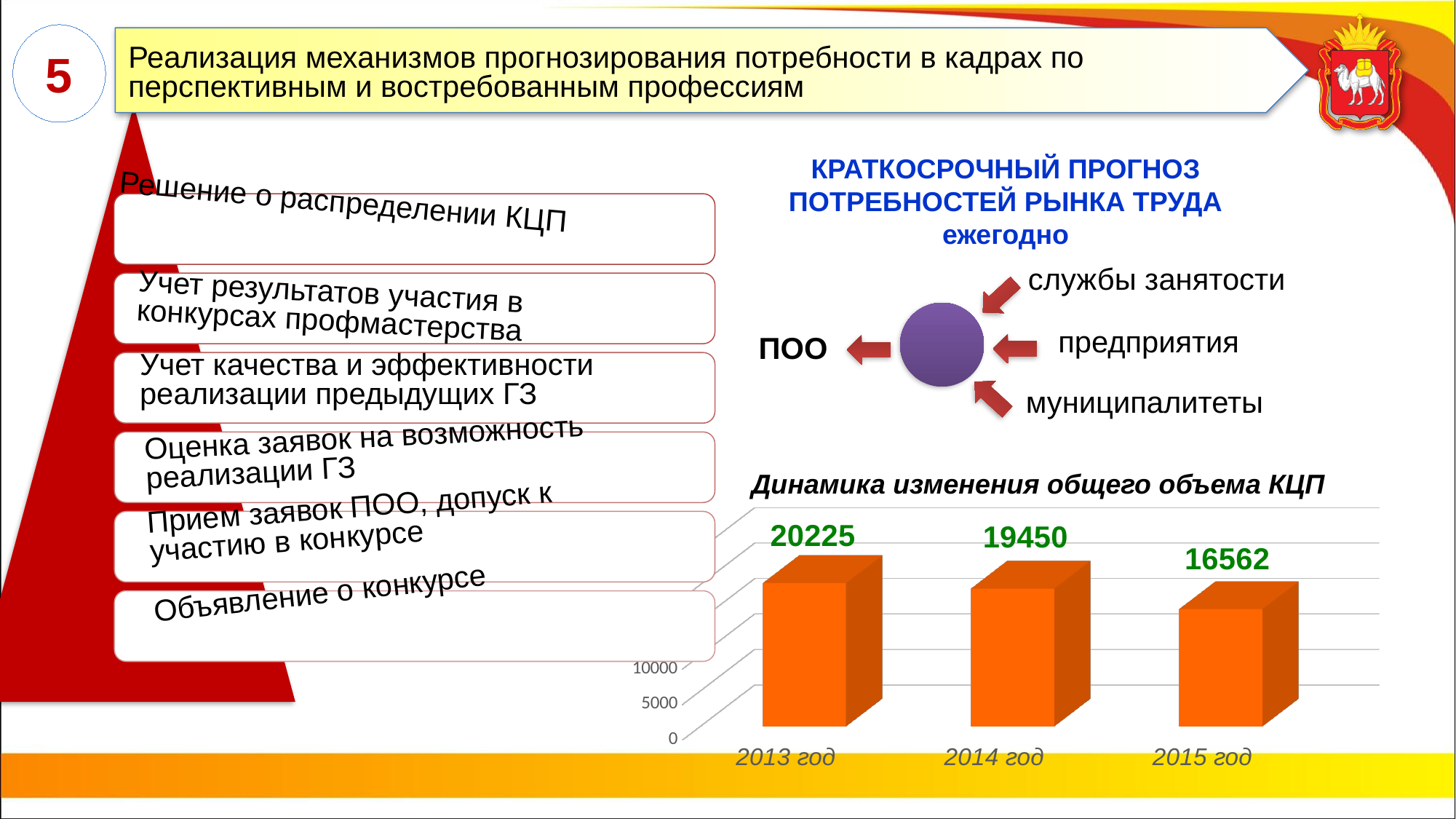
In the chart 'Динамика изменения общего объема КЦП', which is larger: the value for 2014 год or 2015 год? 2014 год What is the value for 2015 год in the chart 'Динамика изменения общего объема КЦП'? 16562 Is the value for 2015 год in the chart 'Динамика изменения общего объема КЦП' greater or less than 10000? greater How many years are shown in the chart 'Динамика изменения общего объема КЦП'? 3 What is the value for 2014 год in the chart 'Динамика изменения общего объема КЦП'? 19450 Which year has the lowest value in the chart 'Динамика изменения общего объема КЦП'? 2015 год What is the difference between the values for 2013 год and 2015 год in the chart 'Динамика изменения общего объема КЦП'? 3663 Which year has the highest value in the chart 'Динамика изменения общего объема КЦП'? 2013 год What is the value for 2013 год in the chart 'Динамика изменения общего объема КЦП'? 20225 What is the difference between the values for 2013 год and 2014 год in the chart 'Динамика изменения общего объема КЦП'? 775 Do the values in the chart 'Динамика изменения общего объема КЦП' rise or fall from 2013 год to 2015 год? fall What kind of chart is 'Динамика изменения общего объема КЦП'? bar chart